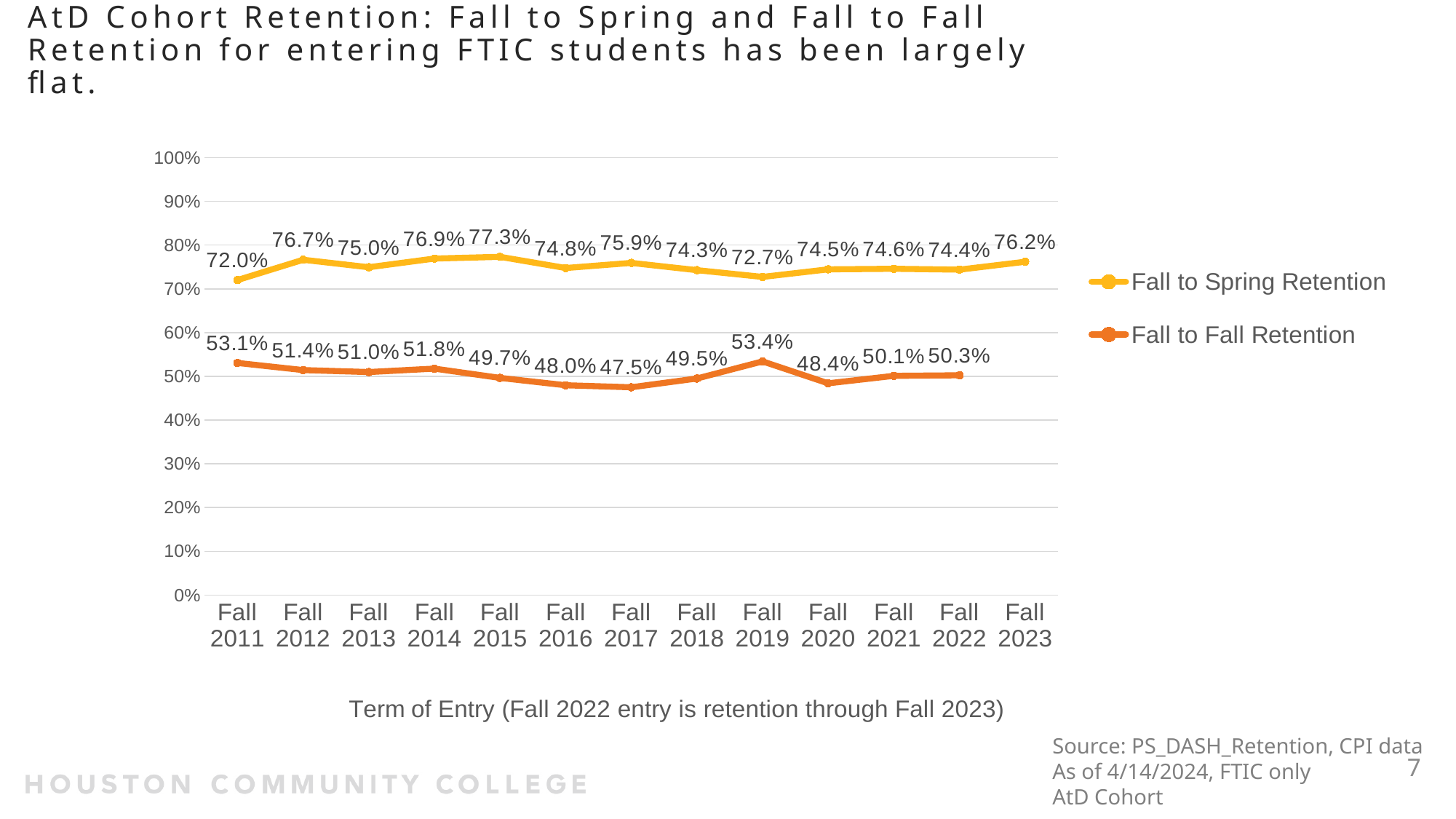
Which series is drawn in yellow? Fall to Spring Retention What is the Fall to Spring Retention value for Fall 2015? 77.3% What kind of chart is shown on the slide? Line chart Which term of entry has the lowest Fall to Spring Retention? Fall 2011 Which term of entry has the highest Fall to Spring Retention? Fall 2015 Which is larger, the Fall to Fall Retention for Fall 2019 or for Fall 2020? Fall 2019 How many terms of entry are shown on the x axis? 13 How many series does the legend list? 2 Which term of entry has the lowest Fall to Fall Retention? Fall 2017 What is the Fall to Spring Retention value for Fall 2011? 72.0% What is the Fall to Fall Retention value for Fall 2019? 53.4% What is the difference between Fall to Spring Retention and Fall to Fall Retention for Fall 2015? 27.6 percentage points